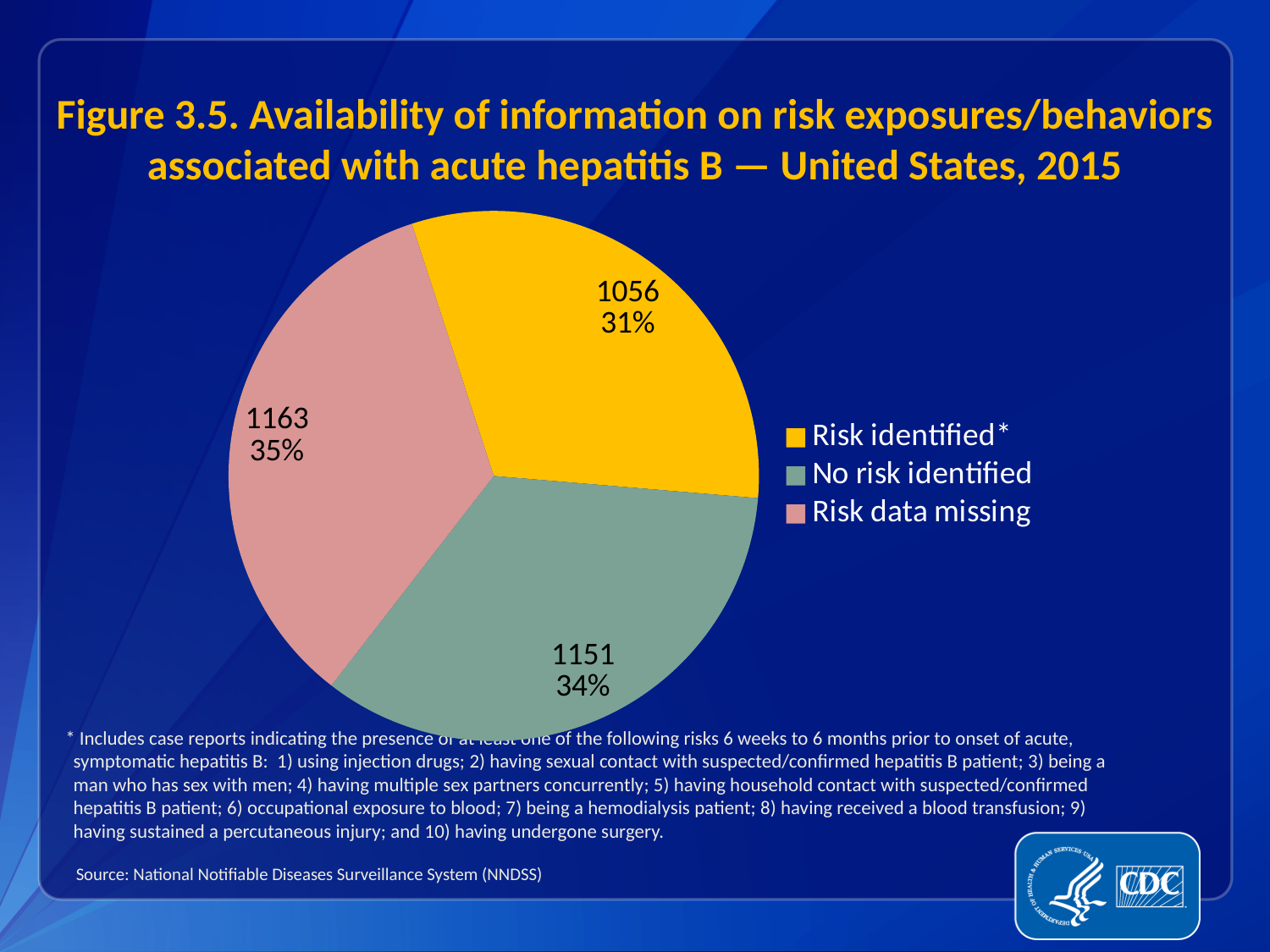
What is the number of cases for 'Risk identified*'? 1056 What share of the pie does 'Risk data missing' represent? 35% How many slices does the pie chart have? 3 What share of the pie does 'Risk identified*' represent? 31% What is the number of cases for 'No risk identified'? 1151 Which colour represents 'No risk identified' in the pie chart? green What is the difference between the number of cases for 'Risk data missing' and 'Risk identified*'? 107 Which category has the largest slice of the pie? Risk data missing Which category has the smallest slice of the pie? Risk identified* How many entries does the legend list? 3 What is the number of cases for 'Risk data missing'? 1163 What kind of chart is shown on the slide? pie chart